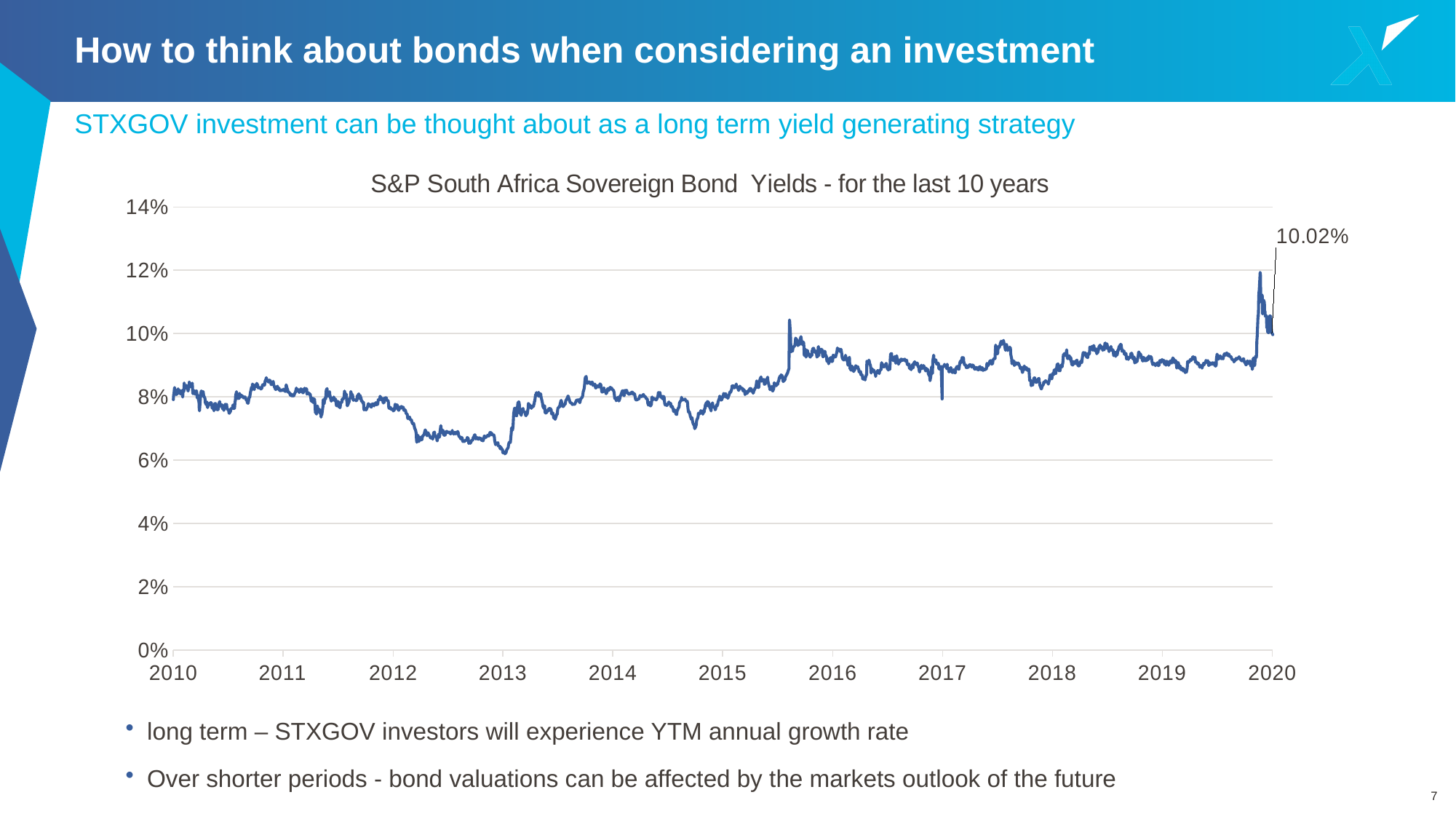
What is the title of the chart? S&P South Africa Sovereign Bond Yields - for the last 10 years Is the highest spike of the line, near the end of 2019, greater or less than 10%? greater Is the lowest point of the line, around the start of 2013, greater or less than 8%? less How many year labels are shown on the x axis? 11 Is the yield at the start of 2010 greater or less than 10%? less What kind of chart is shown on the slide? line chart What is the value shown by the data label at the end of the line in 2020? 10.02% What is the highest value shown on the y axis? 14% Is the yield at the start of 2013 higher or lower than the yield at the start of 2016? lower Overall, does the yield rise or fall from 2010 to 2020? rise